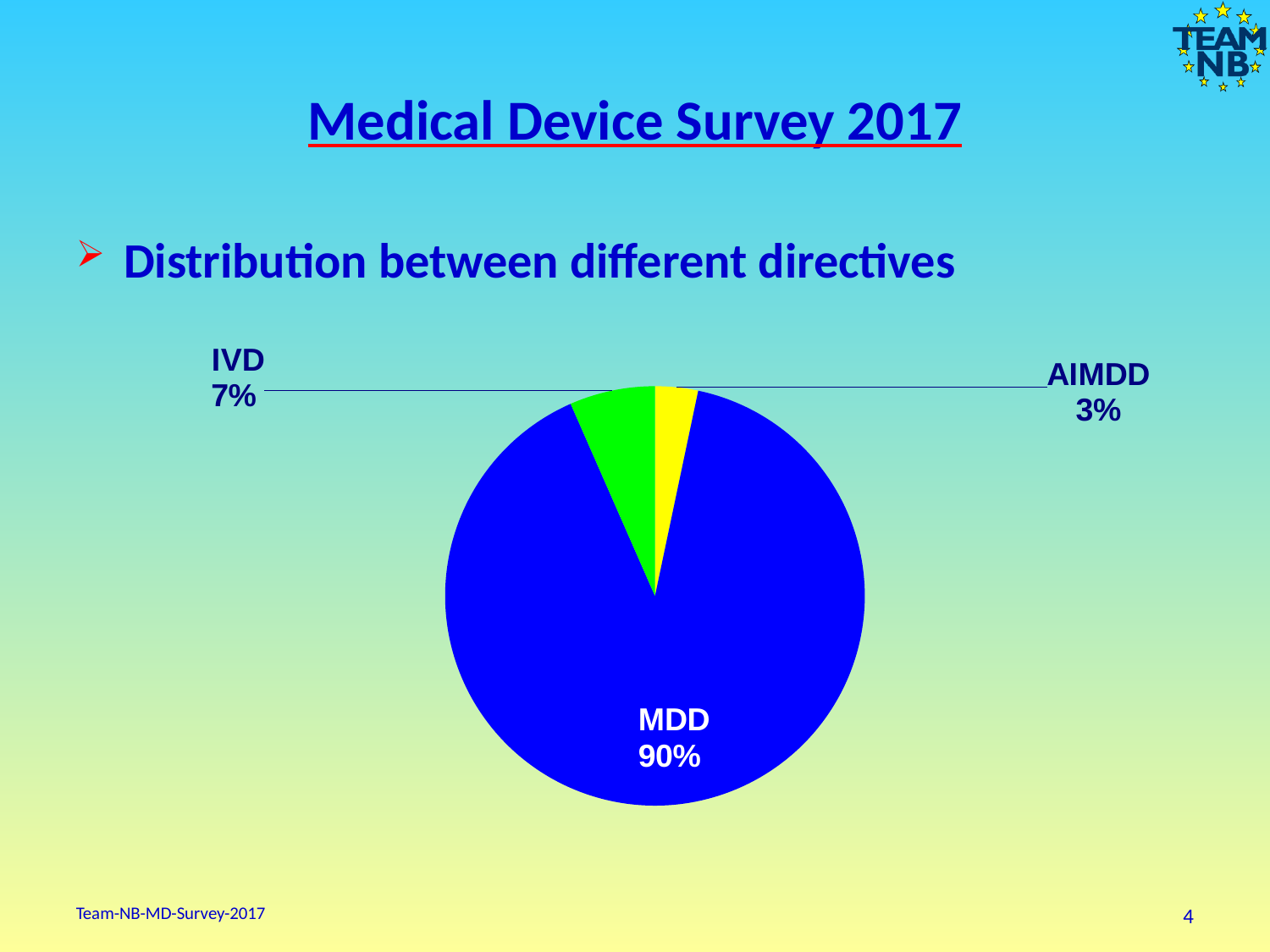
Which slice is larger, IVD or AIMDD? IVD What share of the pie does AIMDD represent? 3% Which directive has the smallest slice of the pie? AIMDD What colour is the MDD slice of the pie? blue What is the difference in percentage points between the IVD and AIMDD slices? 4 What share of the pie does MDD represent? 90% What is the difference in percentage points between the MDD and IVD slices? 83 Which directive has the largest slice of the pie? MDD What share of the pie does IVD represent? 7% What kind of chart is shown on the slide? pie chart How many slices does the pie chart have? 3 What colour is the IVD slice of the pie? green